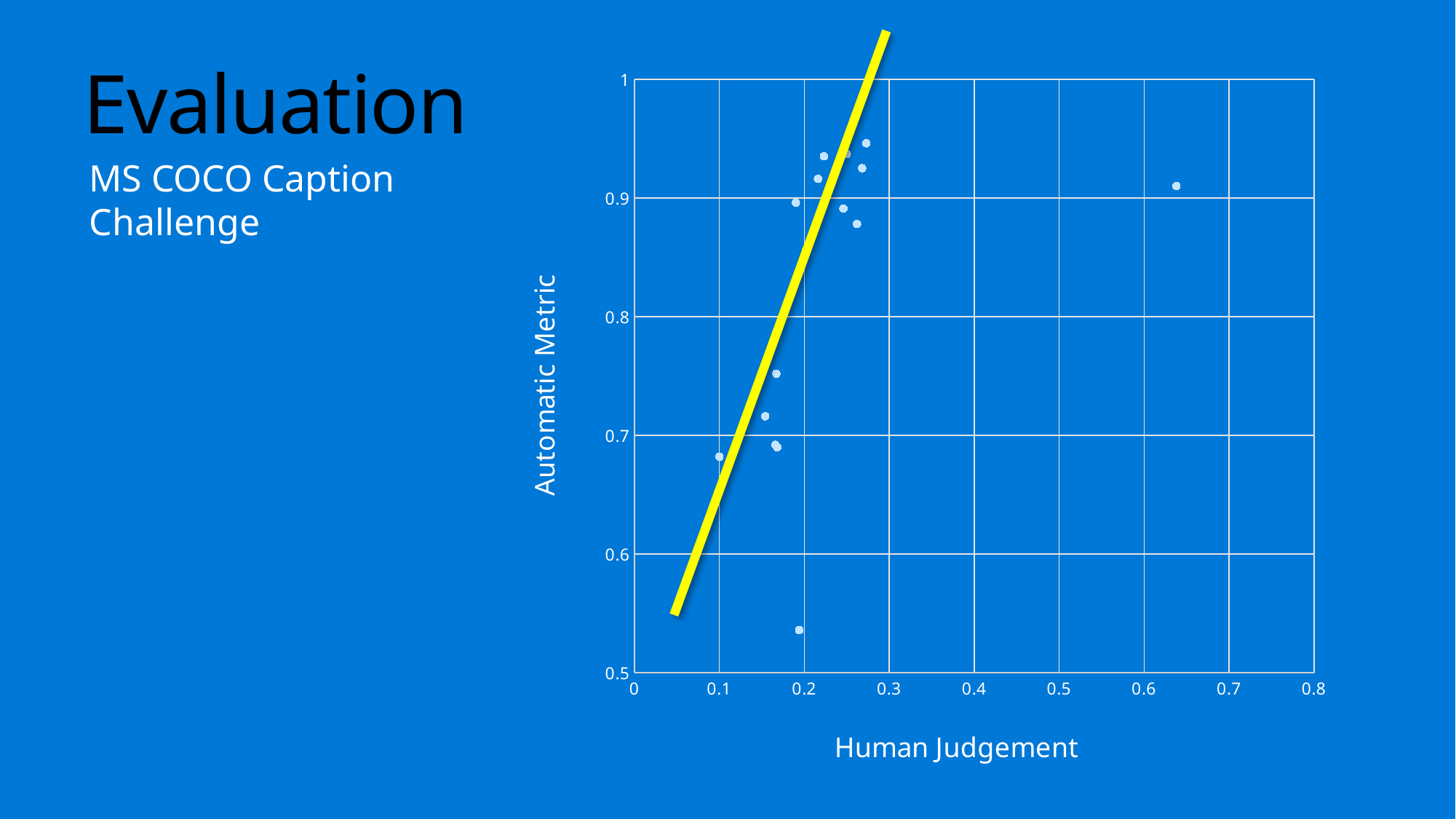
Is the highest Automatic Metric value plotted on the chart greater or less than 0.9? greater Do the Automatic Metric values generally rise or fall as Human Judgement increases from 0.1 to 0.3? rise What is the title of the vertical axis of the chart? Automatic Metric What kind of chart is shown on the slide? scatter chart What is the maximum value shown on the Human Judgement axis? 0.8 Which has the larger Automatic Metric value: the leftmost point or the rightmost point on the chart? the rightmost point Is the Automatic Metric value of the lowest point on the chart greater or less than 0.6? less Is the Human Judgement value of the rightmost point on the chart greater or less than 0.5? greater What is the title of the horizontal axis of the chart? Human Judgement